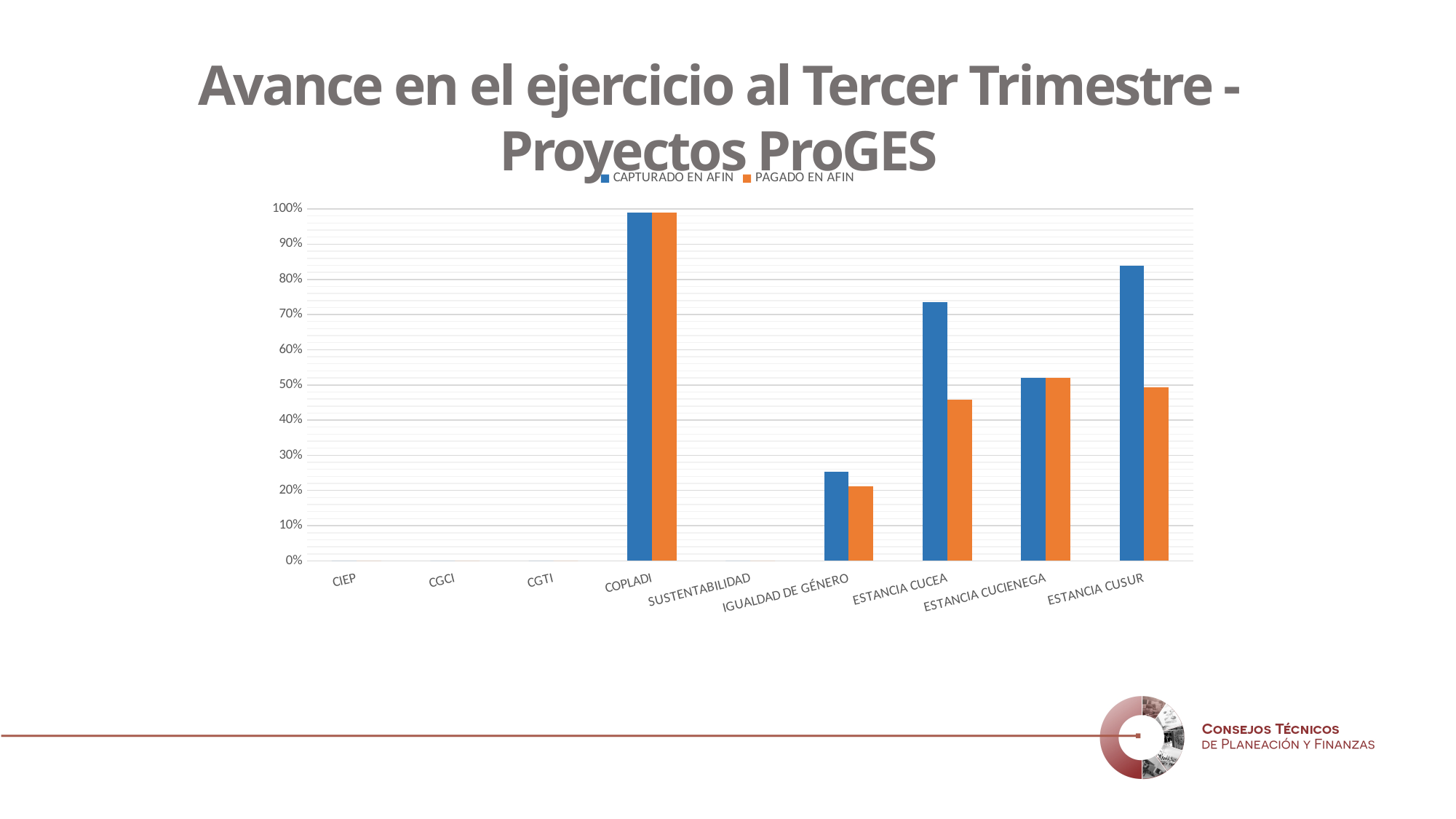
Is the CAPTURADO EN AFIN value for ESTANCIA CUCEA greater or less than 70%? greater Which category has a higher CAPTURADO EN AFIN value: ESTANCIA CUCEA or ESTANCIA CUCIENEGA? ESTANCIA CUCEA Is the CAPTURADO EN AFIN value for IGUALDAD DE GÉNERO greater or less than 30%? less Is the PAGADO EN AFIN value for ESTANCIA CUCEA greater or less than 50%? less Which is larger for ESTANCIA CUSUR: CAPTURADO EN AFIN or PAGADO EN AFIN? CAPTURADO EN AFIN Which category has the highest CAPTURADO EN AFIN value? COPLADI How many series does the legend list? 2 What colour represents the PAGADO EN AFIN series? Orange How many categories are shown on the x axis? 9 Which category has the highest PAGADO EN AFIN value? COPLADI What kind of chart is shown on the slide? Bar chart